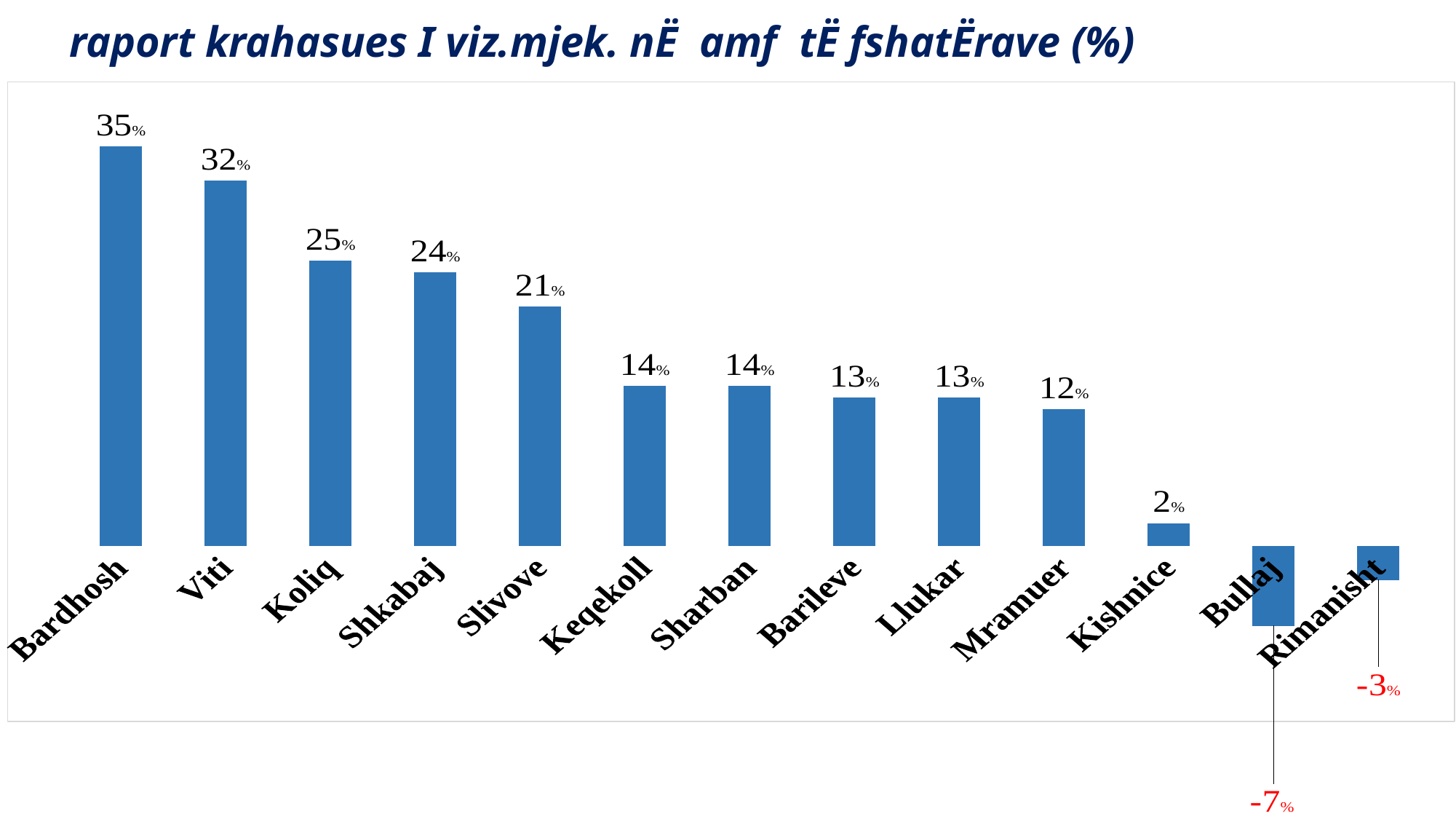
What is the value for Bullaj? -7% How many categories are shown in the chart? 13 What kind of chart is shown on the slide? Bar chart Which is larger, the value for Shkabaj or the value for Keqekoll? Shkabaj Which category has the highest value? Bardhosh Do the values rise or fall from left to right along the x axis? Fall Which category has the lowest value? Bullaj What is the difference between the values for Bardhosh and Viti? 3% What is the value for Bardhosh? 35% What is the value for Kishnice? 2% What is the difference between the values for Koliq and Mramuer? 13% What is the value for Slivove? 21%